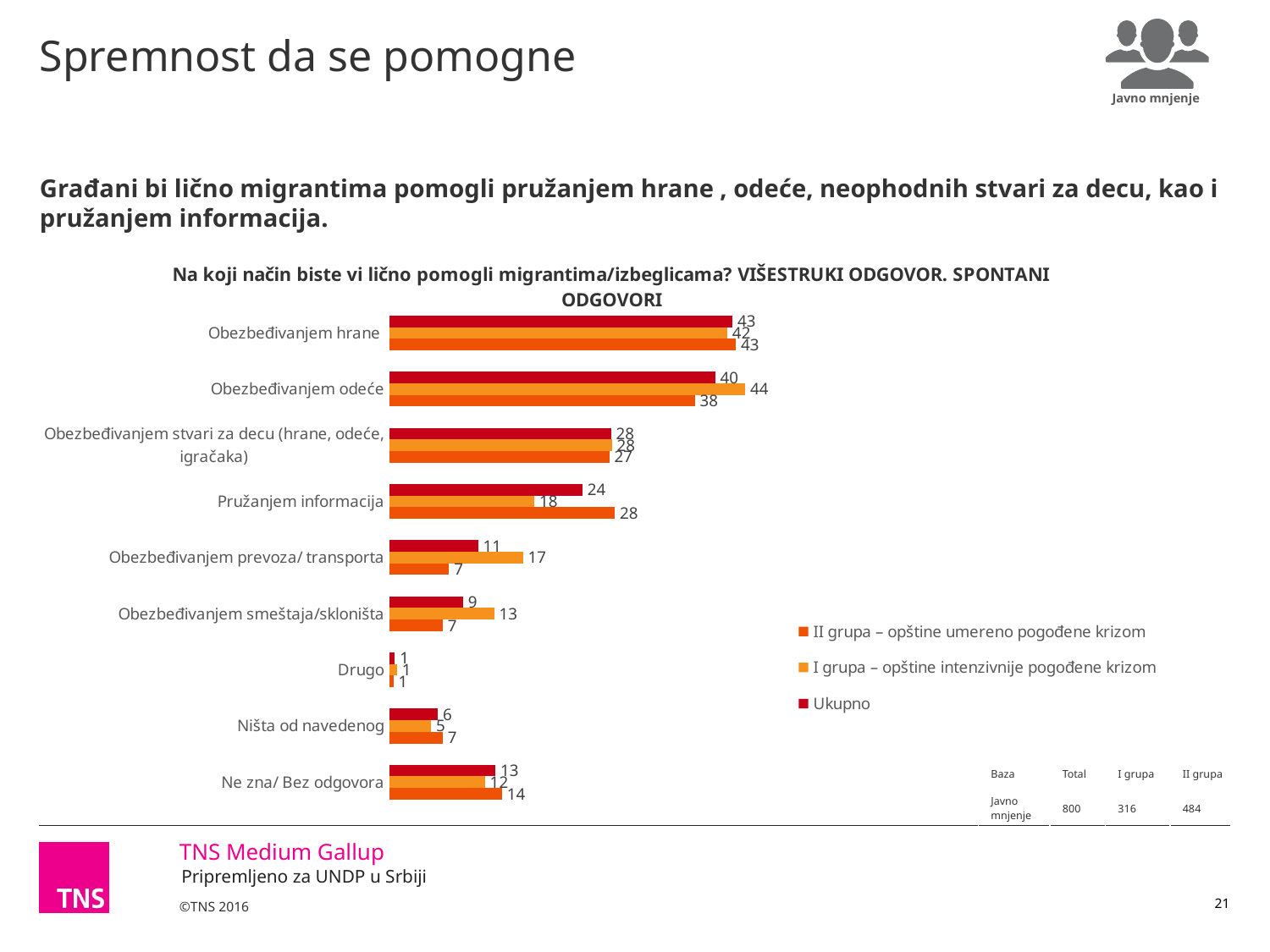
How many categories are shown on the chart? 9 Which category has the lowest Ukupno value? Drugo What is the Ukupno value for "Obezbeđivanjem odeće"? 40 Which category has the highest Ukupno value? Obezbeđivanjem hrane How many series does the legend list? 3 For "Obezbeđivanjem odeće", which is larger: the I grupa value or the II grupa value? I grupa Which series is shown in dark red in the legend? Ukupno What kind of chart is shown on the slide? Bar chart What is the difference between the I grupa and II grupa values for "Obezbeđivanjem prevoza/ transporta"? 10 What is the Ukupno value for "Ne zna/ Bez odgovora"? 13 What is the value for "I grupa – opštine intenzivnije pogođene krizom" for "Pružanjem informacija"? 18 What is the value for "II grupa – opštine umereno pogođene krizom" for "Obezbeđivanjem prevoza/ transporta"? 7